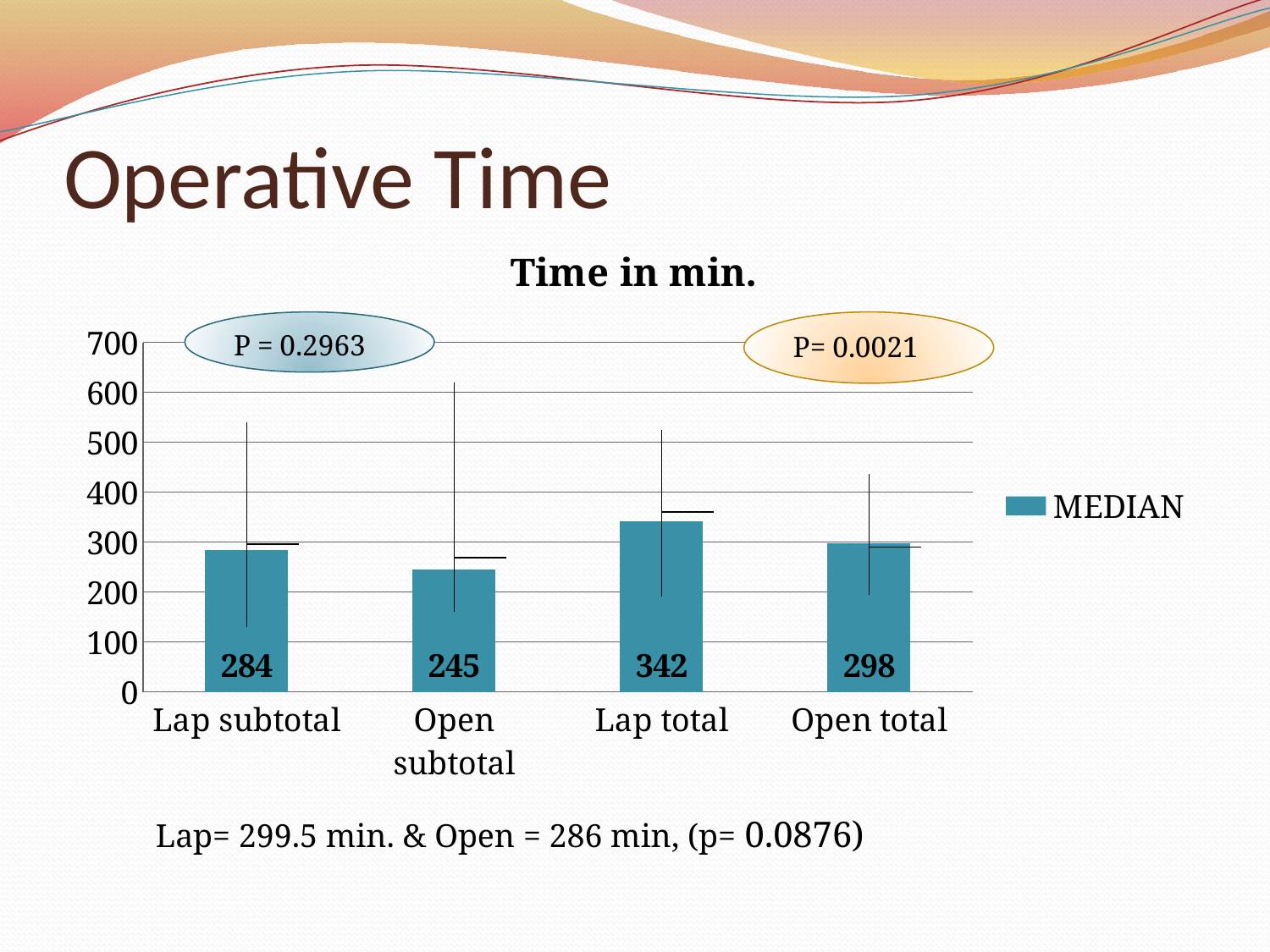
What is the median operative time for Open total? 298 What is the title of the chart? Time in min. What is the difference between the median values for Lap total and Open total? 44 What is the difference between the median values for Lap subtotal and Open subtotal? 39 What is the median operative time for Lap total? 342 How many categories are shown on the x axis? 4 Which category has the highest median operative time? Lap total Which is larger, the median for Lap subtotal or the median for Open total? Open total What is the median operative time for Lap subtotal? 284 What is the median operative time for Open subtotal? 245 What type of chart is shown on the slide? Bar chart Which category has the lowest median operative time? Open subtotal